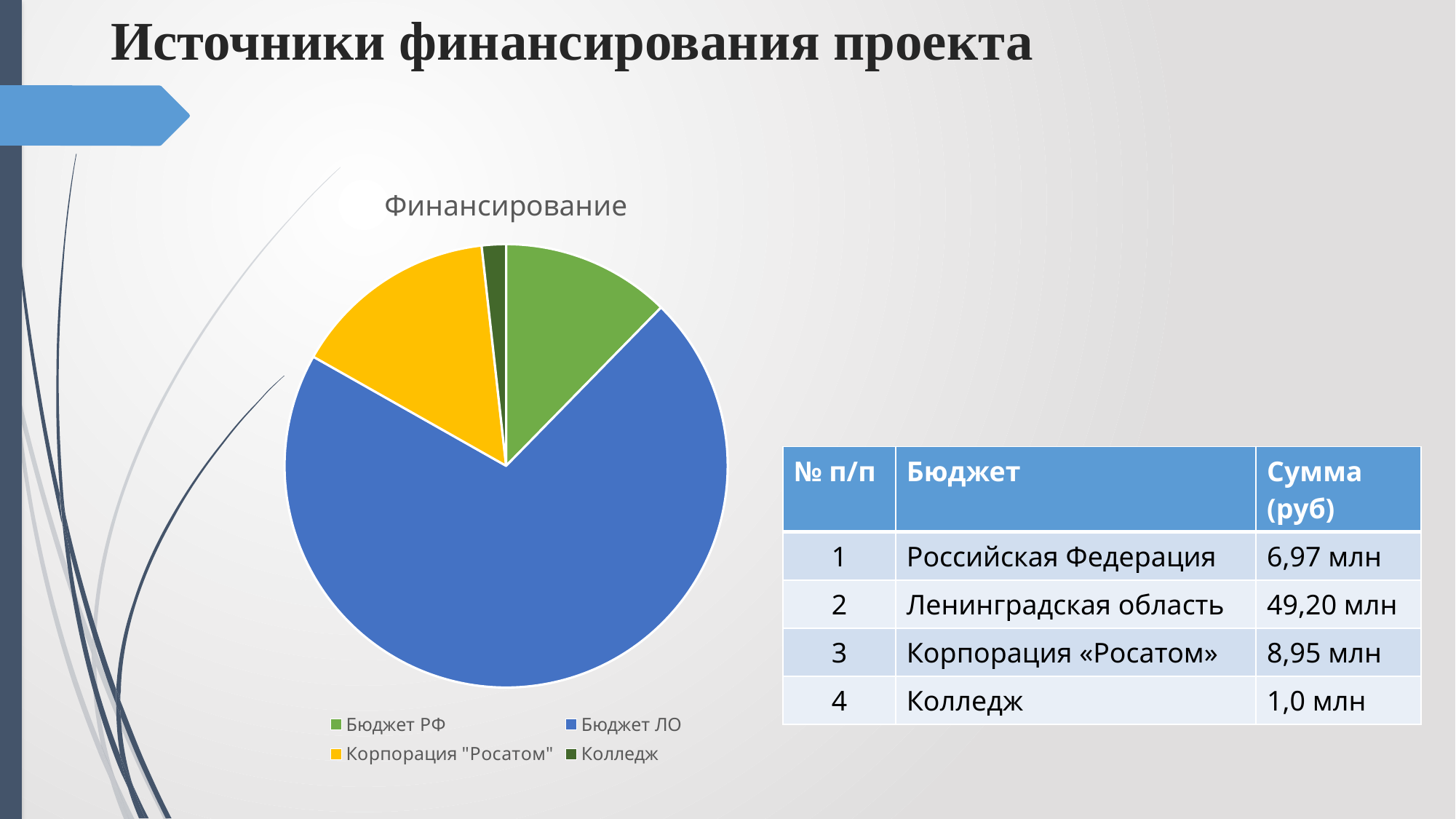
Which slice is larger in the pie chart: Бюджет ЛО or Корпорация "Росатом"? Бюджет ЛО Which slice is larger in the pie chart: Корпорация "Росатом" or Бюджет РФ? Корпорация "Росатом" What kind of chart is shown on the slide? pie chart Which category has the smallest slice in the pie chart? Колледж What colour is the Бюджет ЛО slice in the pie chart? blue Which slice is larger in the pie chart: Бюджет РФ or Колледж? Бюджет РФ How many slices does the pie chart have? 4 Which category has the largest slice in the pie chart? Бюджет ЛО How many entries does the legend of the pie chart list? 4 What is the title of the pie chart? Финансирование